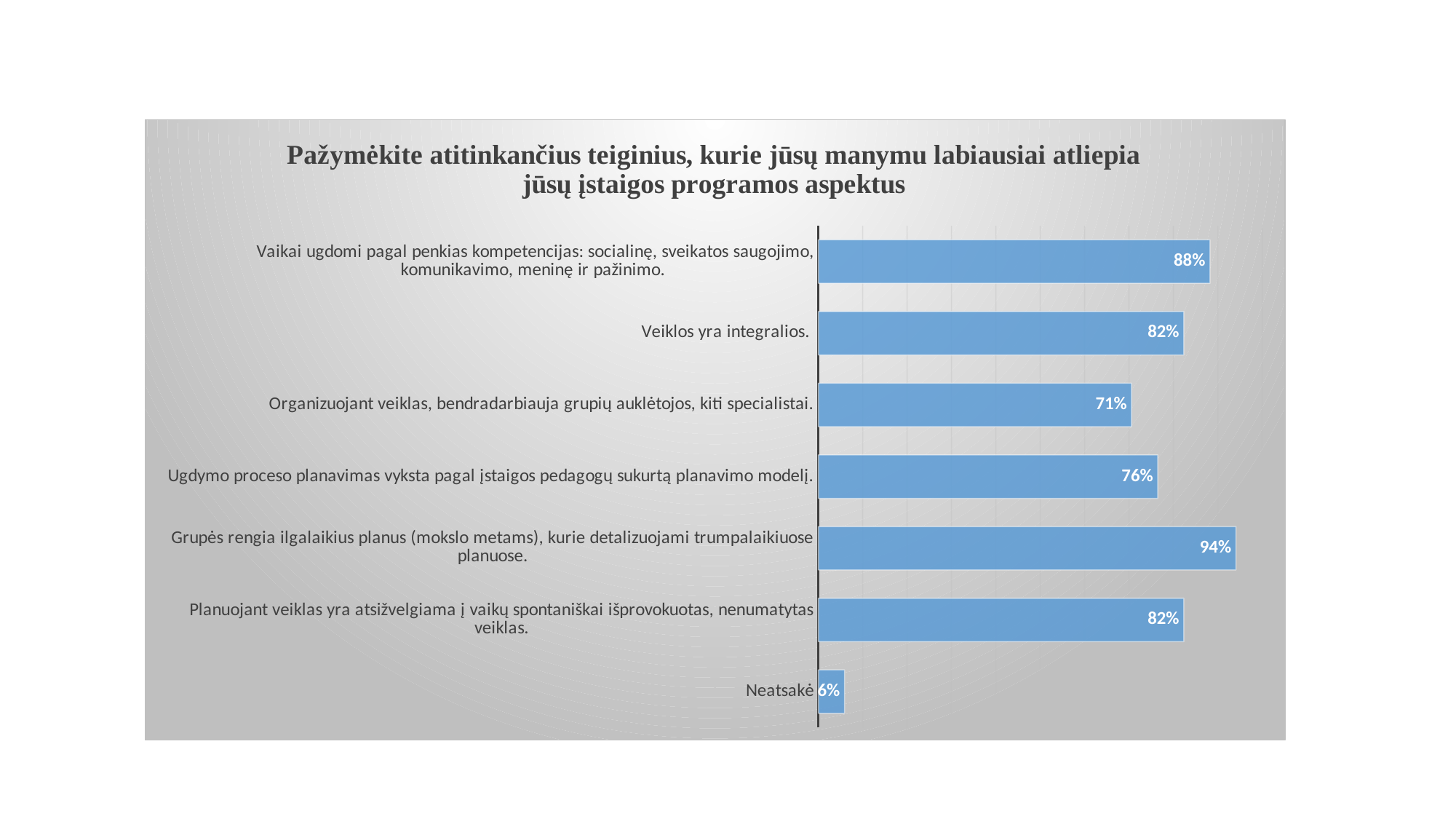
What is the difference between the value for "Grupės rengia ilgalaikius planus (mokslo metams), kurie detalizuojami trumpalaikiuose planuose." and the value for "Vaikai ugdomi pagal penkias kompetencijas: socialinę, sveikatos saugojimo, komunikavimo, meninę ir pažinimo."? 6% What kind of chart is shown on the slide? Bar chart What is the value for "Veiklos yra integralios."? 82% What is the value for "Ugdymo proceso planavimas vyksta pagal įstaigos pedagogų sukurtą planavimo modelį."? 76% What is the difference between the value for "Veiklos yra integralios." and the value for "Neatsakė"? 76% What is the title of the chart? Pažymėkite atitinkančius teiginius, kurie jūsų manymu labiausiai atliepia jūsų įstaigos programos aspektus What is the value for "Organizuojant veiklas, bendradarbiauja grupių auklėtojos, kiti specialistai."? 71% What is the value for "Neatsakė"? 6% Which category has the lowest value? Neatsakė Which category has the highest value? Grupės rengia ilgalaikius planus (mokslo metams), kurie detalizuojami trumpalaikiuose planuose. How many categories are shown in the chart? 7 Which is larger: the value for "Ugdymo proceso planavimas vyksta pagal įstaigos pedagogų sukurtą planavimo modelį." or the value for "Organizuojant veiklas, bendradarbiauja grupių auklėtojos, kiti specialistai."? Ugdymo proceso planavimas vyksta pagal įstaigos pedagogų sukurtą planavimo modelį.